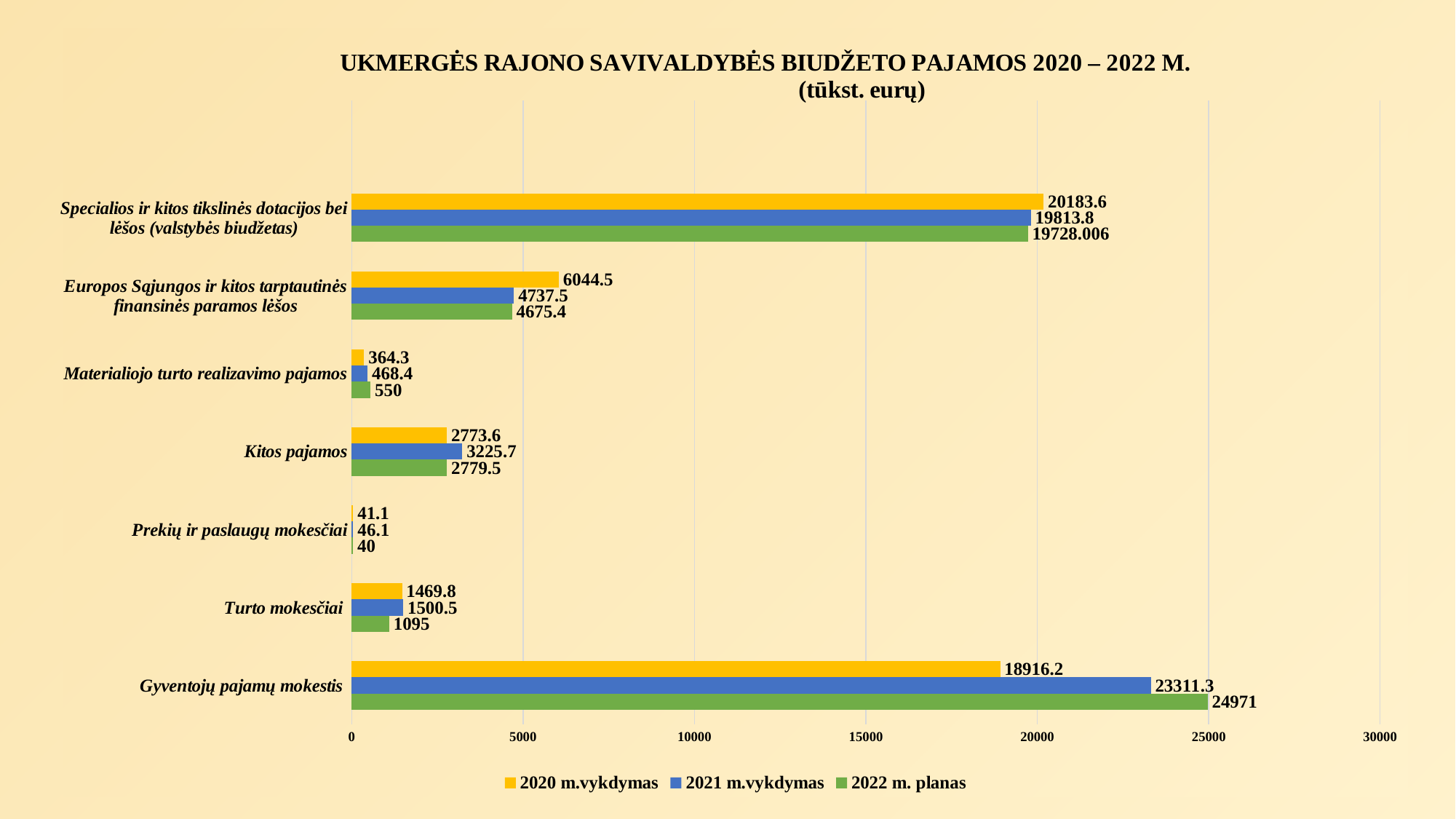
For Kitos pajamos, which series has the larger value: 2021 m.vykdymas or 2022 m. planas? 2021 m.vykdymas What is the value for Turto mokesčiai in the 2021 m.vykdymas series? 1500.5 Which category has the lowest value in the 2020 m.vykdymas series? Prekių ir paslaugų mokesčiai How many series does the legend list? 3 Which category has the highest value in the 2022 m. planas series? Gyventojų pajamų mokestis How many categories are shown on the chart? 7 Is the 2020 m.vykdymas value for Europos Sąjungos ir kitos tarptautinės finansinės paramos lėšos greater or less than 5000? greater For Gyventojų pajamų mokestis, how much larger is the 2021 m.vykdymas value than the 2020 m.vykdymas value? 4395.1 For Materialiojo turto realizavimo pajamos, what is the difference between the 2022 m. planas value and the 2020 m.vykdymas value? 185.7 What kind of chart is shown on the slide? bar chart What is the value for Gyventojų pajamų mokestis in the 2022 m. planas series? 24971 What is the 2022 m. planas value for Specialios ir kitos tikslinės dotacijos bei lėšos (valstybės biudžetas)? 19728.006